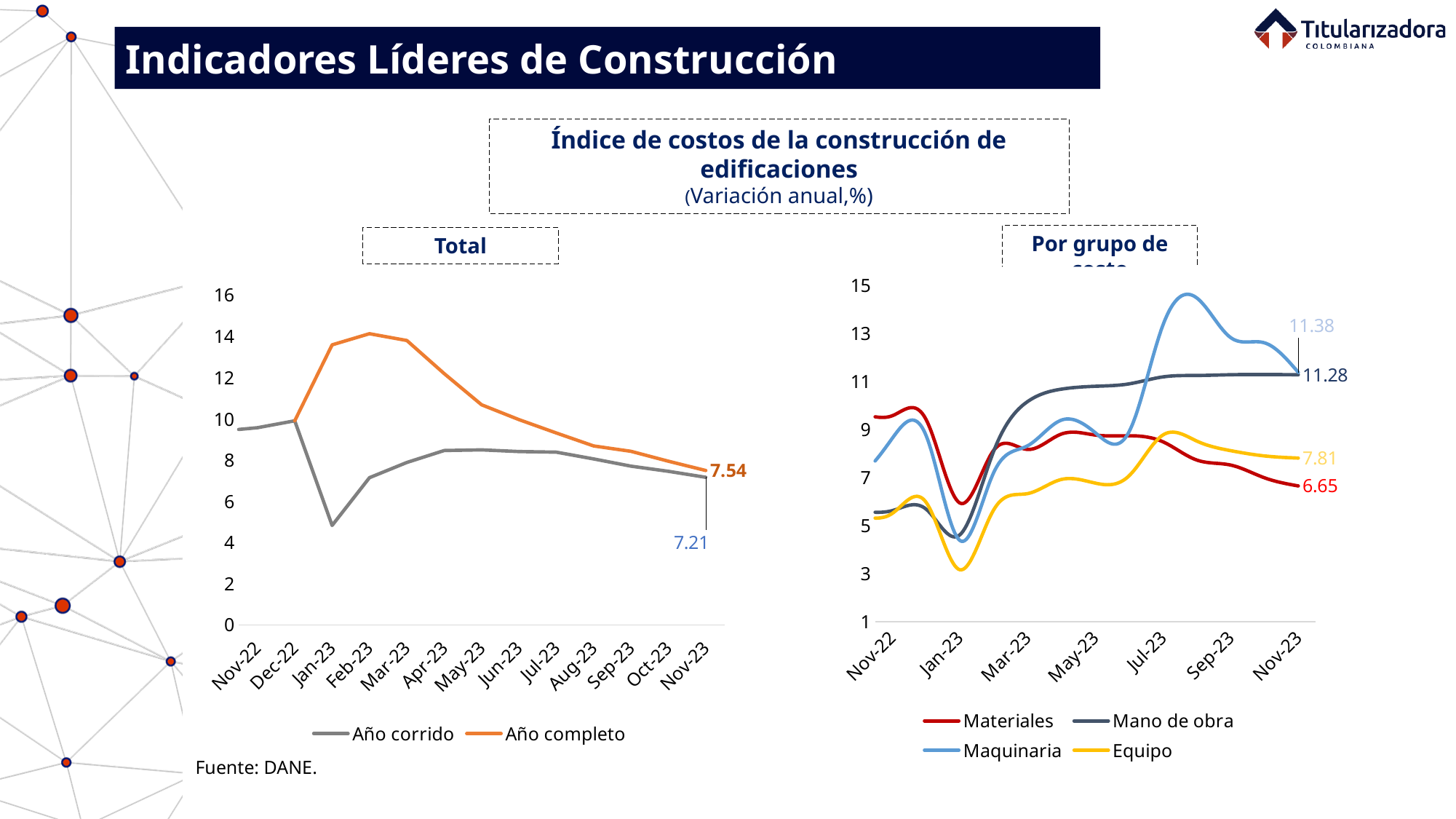
In the 'Total' chart, what is the difference between Año completo and Año corrido in Nov-23? 0.33 In the 'Total' chart, how many months are shown on the x axis? 13 In the 'Total' chart, is the value of Año completo in Feb-23 greater or less than 12? greater In the 'Total' chart, how many series does the legend list? 2 In the 'Total' chart, does Año completo rise or fall from Mar-23 to Nov-23? fall What kind of chart is the 'Por grupo de costo' chart? line chart In the 'Total' chart, what is the value of Año corrido in Nov-23? 7.21 In the 'Por grupo de costo' chart, how many series does the legend list? 4 In the 'Por grupo de costo' chart, which series has the lowest value in Nov-23? Materiales In the 'Total' chart, what is the value of Año completo in Nov-23? 7.54 In the 'Por grupo de costo' chart, what is the value of Maquinaria in Nov-23? 11.38 In the 'Por grupo de costo' chart, what is the value of Materiales in Nov-23? 6.65